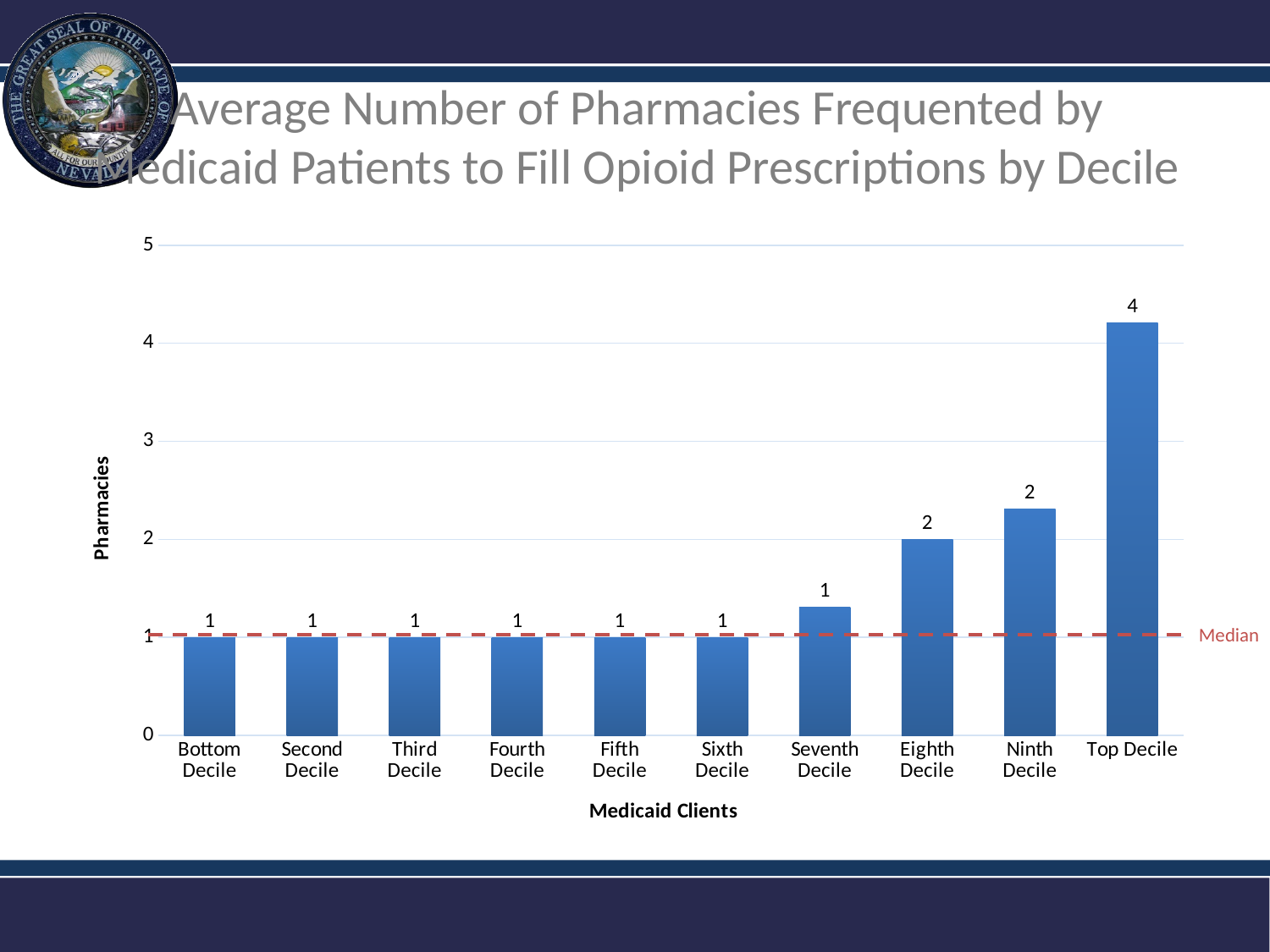
Do the values rise or fall from the Bottom Decile to the Top Decile? rise What is the value for the Eighth Decile? 2 What is the difference between the labelled values for the Top Decile and the Bottom Decile? 3 What is the value for the Bottom Decile? 1 How many deciles are shown on the x axis? 10 What is the value for the Ninth Decile? 2 Which is larger, the value for the Top Decile or the value for the Ninth Decile? Top Decile What is the value for the Top Decile? 4 Which decile has the highest average number of pharmacies? Top Decile What does the red dashed horizontal line represent? Median Is the value for the Ninth Decile greater or less than 3? less What kind of chart is shown on the slide? bar chart